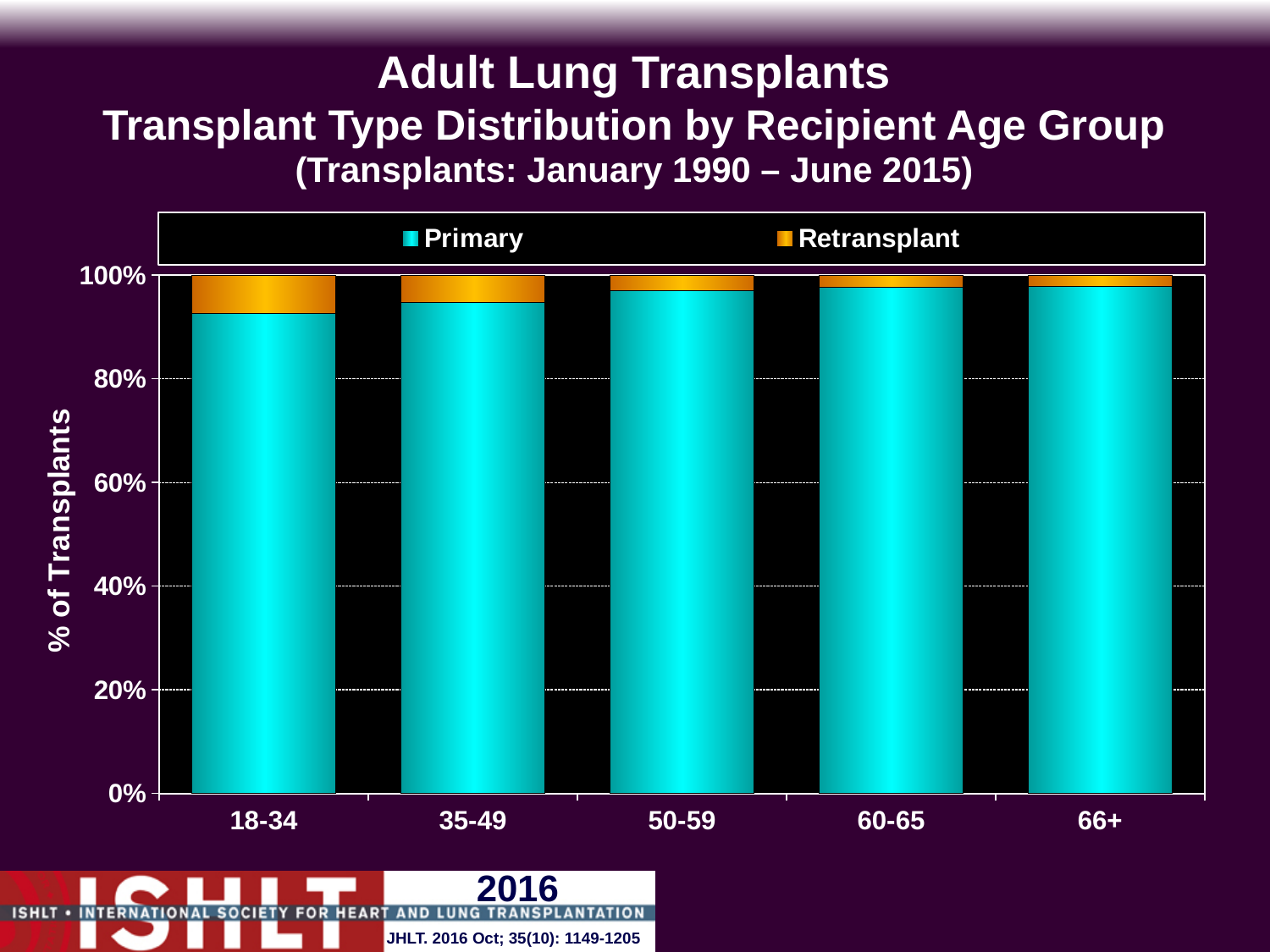
Is the Primary share for the 18-34 age group greater or less than 80%? greater How many series does the legend list? 2 Which two series are listed in the legend? Primary and Retransplant What is the total height of each stacked bar? 100% Which age group has the smallest Primary share? 18-34 Is the Retransplant share for the 66+ age group greater or less than 20%? less What is the title of the chart? Adult Lung Transplants Transplant Type Distribution by Recipient Age Group (Transplants: January 1990 – June 2015) How many recipient age groups are shown on the x axis? 5 Which is larger, the Primary share for 18-34 or the Primary share for 66+? 66+ What kind of chart is shown on the slide? stacked bar chart Does the Retransplant share rise or fall as the age group increases from 18-34 to 66+? fall Which age group has the largest Retransplant share? 18-34